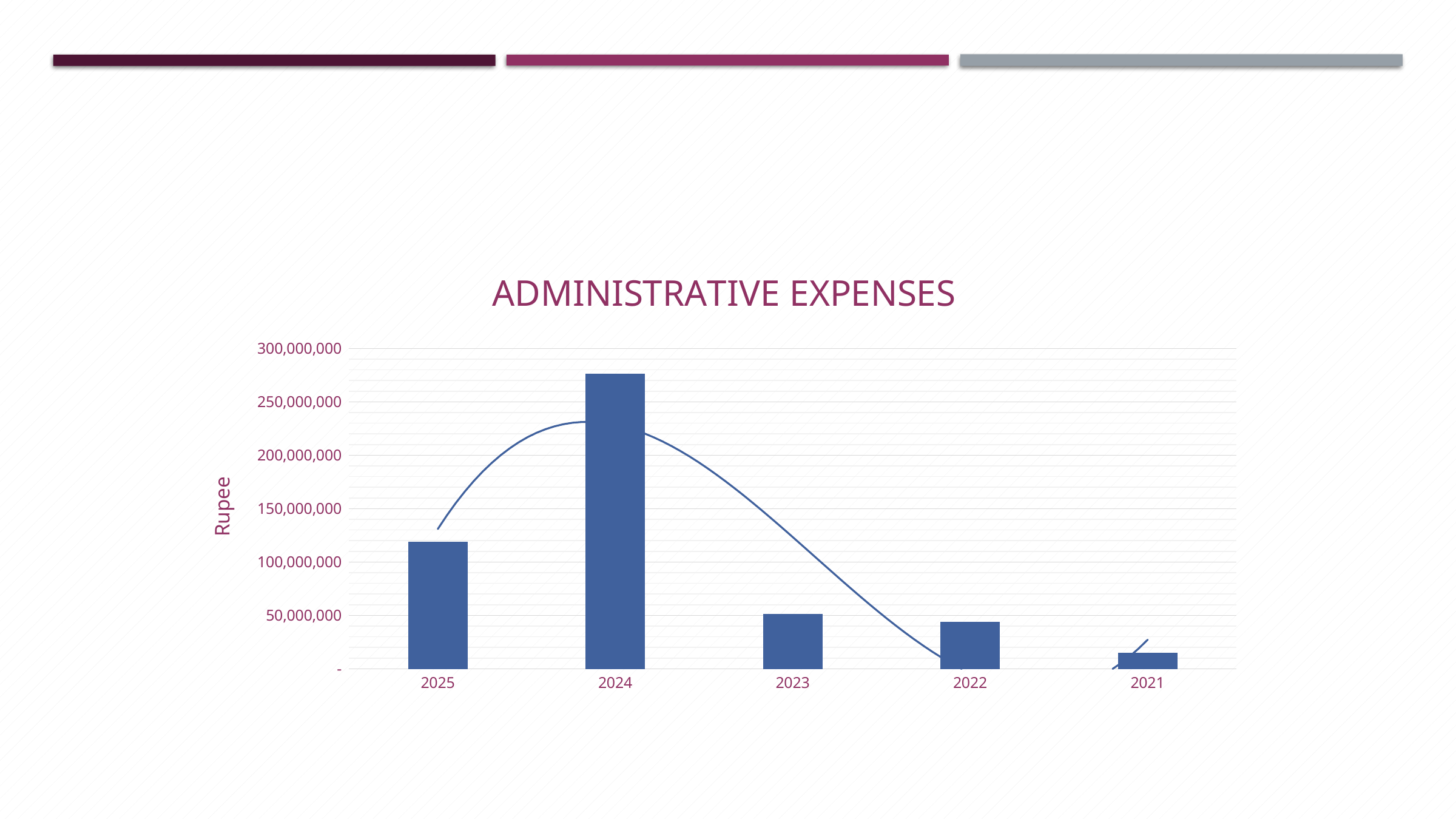
Is the value for 2023 greater or less than 100,000,000? less Is the value for 2024 greater or less than 250,000,000? greater How many years are shown on the x axis of the chart? 5 Moving from 2024 to 2021 along the x axis, do the administrative expenses rise or fall? fall What is the title of the chart? ADMINISTRATIVE EXPENSES What kind of chart is shown on the slide? Bar chart Which year has the lowest administrative expenses? 2021 What is the label on the vertical axis of the chart? Rupee Which year has larger administrative expenses, 2025 or 2023? 2025 Which year has the highest administrative expenses? 2024 Is the value for 2025 greater or less than 100,000,000? greater